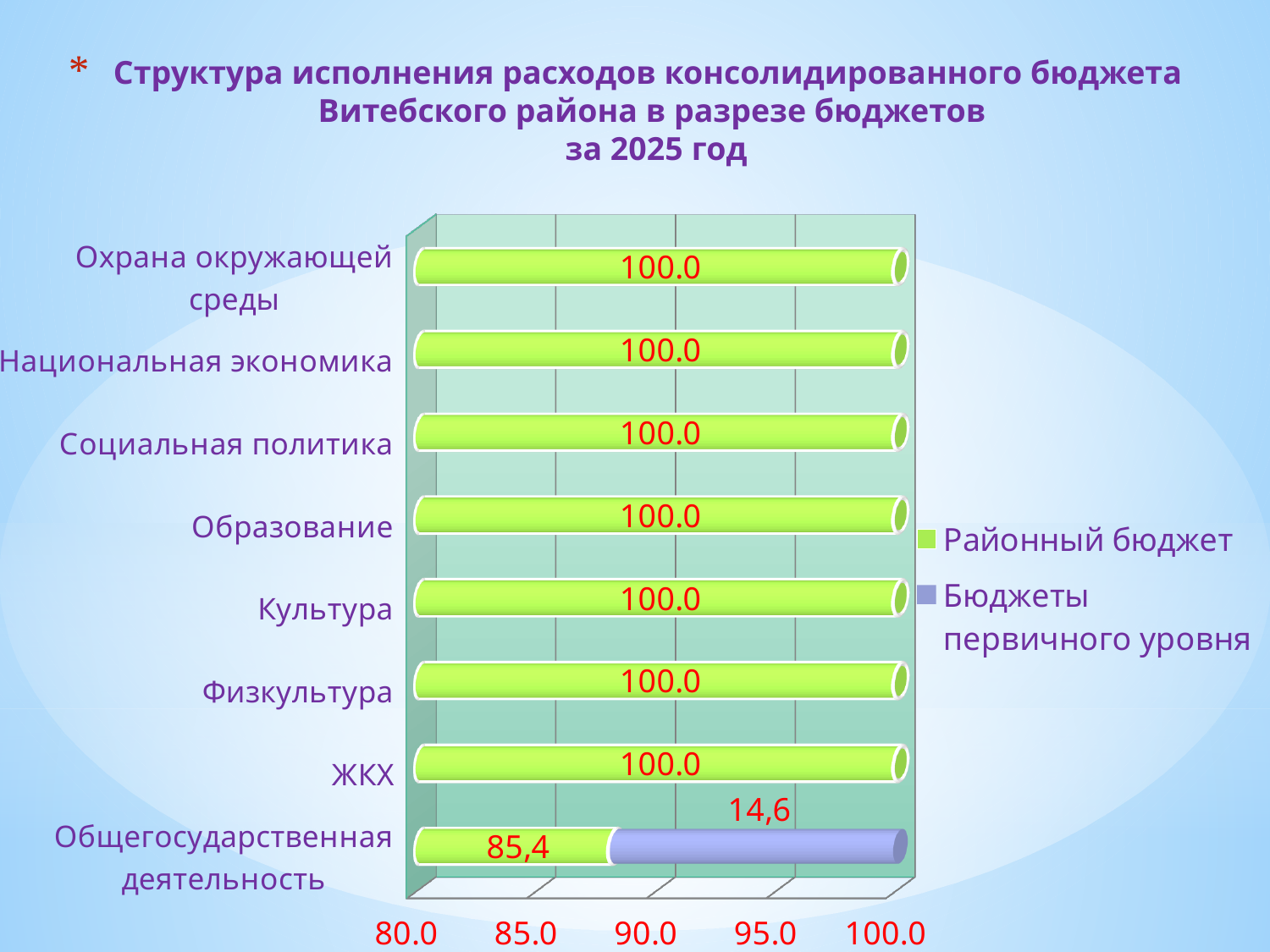
Which is larger for Общегосударственная деятельность: Районный бюджет or Бюджеты первичного уровня? Районный бюджет What is the value of Районный бюджет for ЖКХ? 100.0 What is the value of Районный бюджет for Образование? 100.0 What colour are the Районный бюджет bars? green How many categories are plotted on the chart? 8 How many series does the legend list? 2 What is the value of Районный бюджет for Общегосударственная деятельность? 85,4 What is the difference between the Районный бюджет values for Культура and Общегосударственная деятельность? 14,6 What kind of chart is shown on the slide? bar chart Which category has the lowest value for Районный бюджет? Общегосударственная деятельность What are the two series listed in the legend? Районный бюджет and Бюджеты первичного уровня What is the value of Бюджеты первичного уровня for Общегосударственная деятельность? 14,6